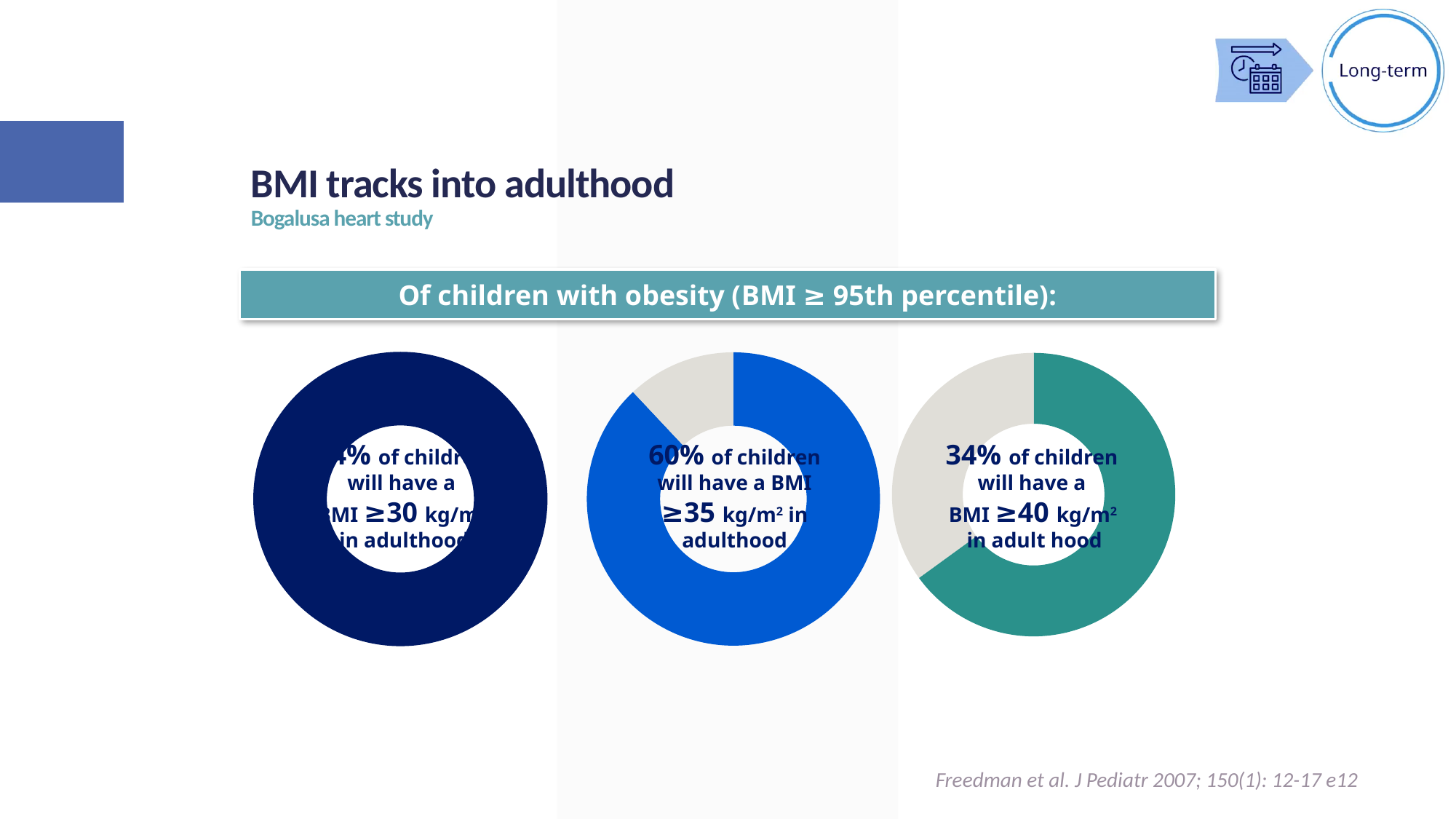
In the middle donut chart, what percentage of children with obesity will have a BMI ≥35 kg/m² in adulthood? 60% What is the difference in percentage points between the middle chart value (BMI ≥35 kg/m²) and the right chart value (BMI ≥40 kg/m²)? 26 percentage points What kind of chart is used to show each percentage on this slide? Donut (pie) chart Which study is named in the subtitle beneath the slide title? Bogalusa heart study Is the value shown in the middle donut chart (BMI ≥35 kg/m²) greater or less than 50%? greater Which is larger: the percentage of children who will have a BMI ≥35 kg/m² (middle chart) or the percentage who will have a BMI ≥40 kg/m² (right chart)? BMI ≥35 kg/m² (60%) What is the title of the slide containing the donut charts? BMI tracks into adulthood Is the value shown in the right-hand donut chart (BMI ≥40 kg/m²) greater or less than 50%? less How many donut charts are shown on the slide? 3 In the right-hand donut chart, what percentage of children with obesity will have a BMI ≥40 kg/m² in adulthood? 34%